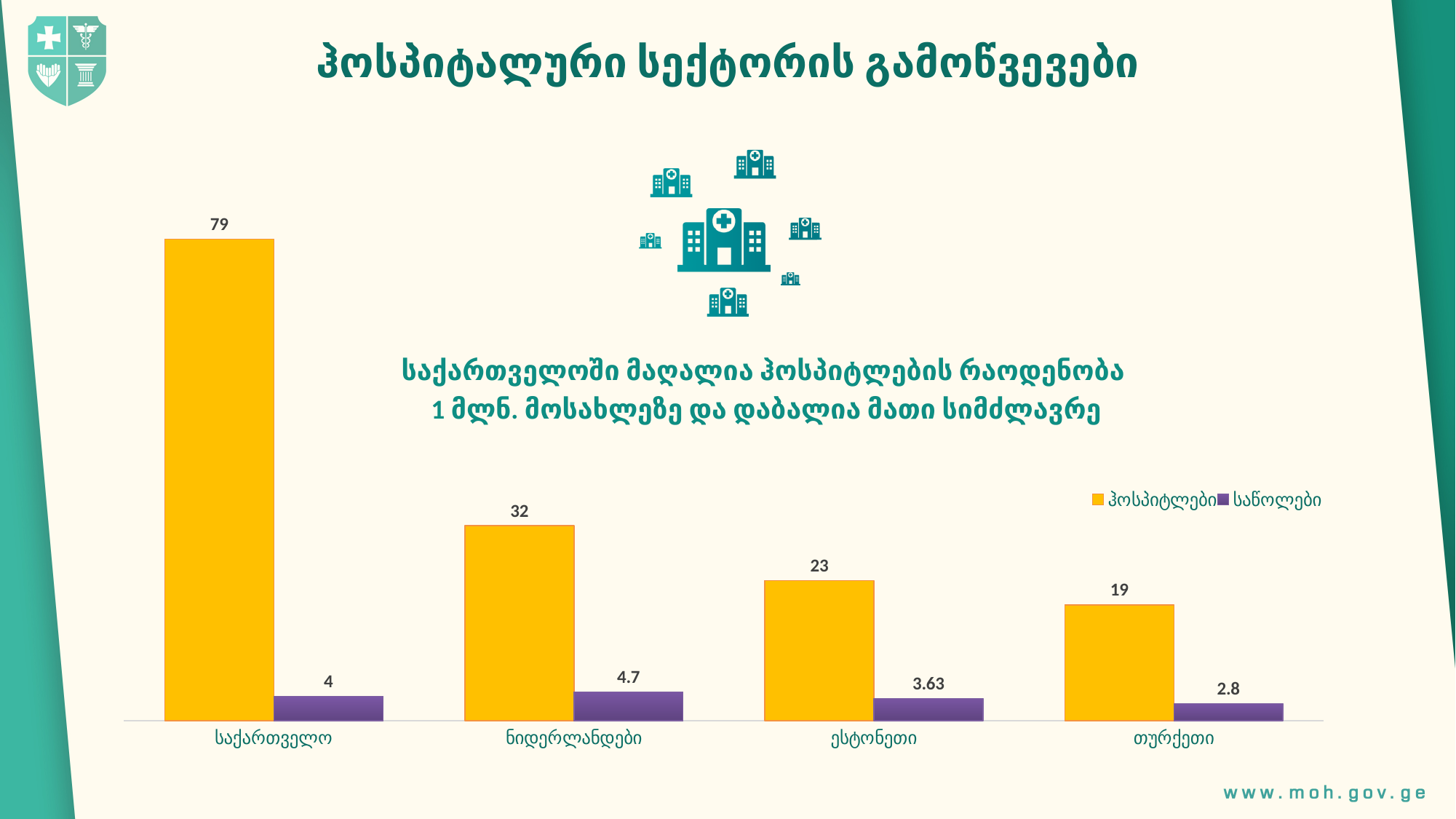
Which colour represents the ჰოსპიტლები series in the chart? yellow Which is larger: the საწოლები value for საქართველო or for ნიდერლანდები? ნიდერლანდები Which category has the highest ჰოსპიტლები value? საქართველო What is the value of the საწოლები bar for ნიდერლანდები? 4.7 What kind of chart is shown on the slide? bar chart What is the value of the ჰოსპიტლები bar for საქართველო? 79 Which category has the lowest საწოლები value? თურქეთი What is the value of the ჰოსპიტლები bar for თურქეთი? 19 How many series does the legend list? 2 What is the value of the საწოლები bar for ესტონეთი? 3.63 What is the difference between the ჰოსპიტლები values for საქართველო and ნიდერლანდები? 47 How many categories are shown on the x axis of the chart? 4